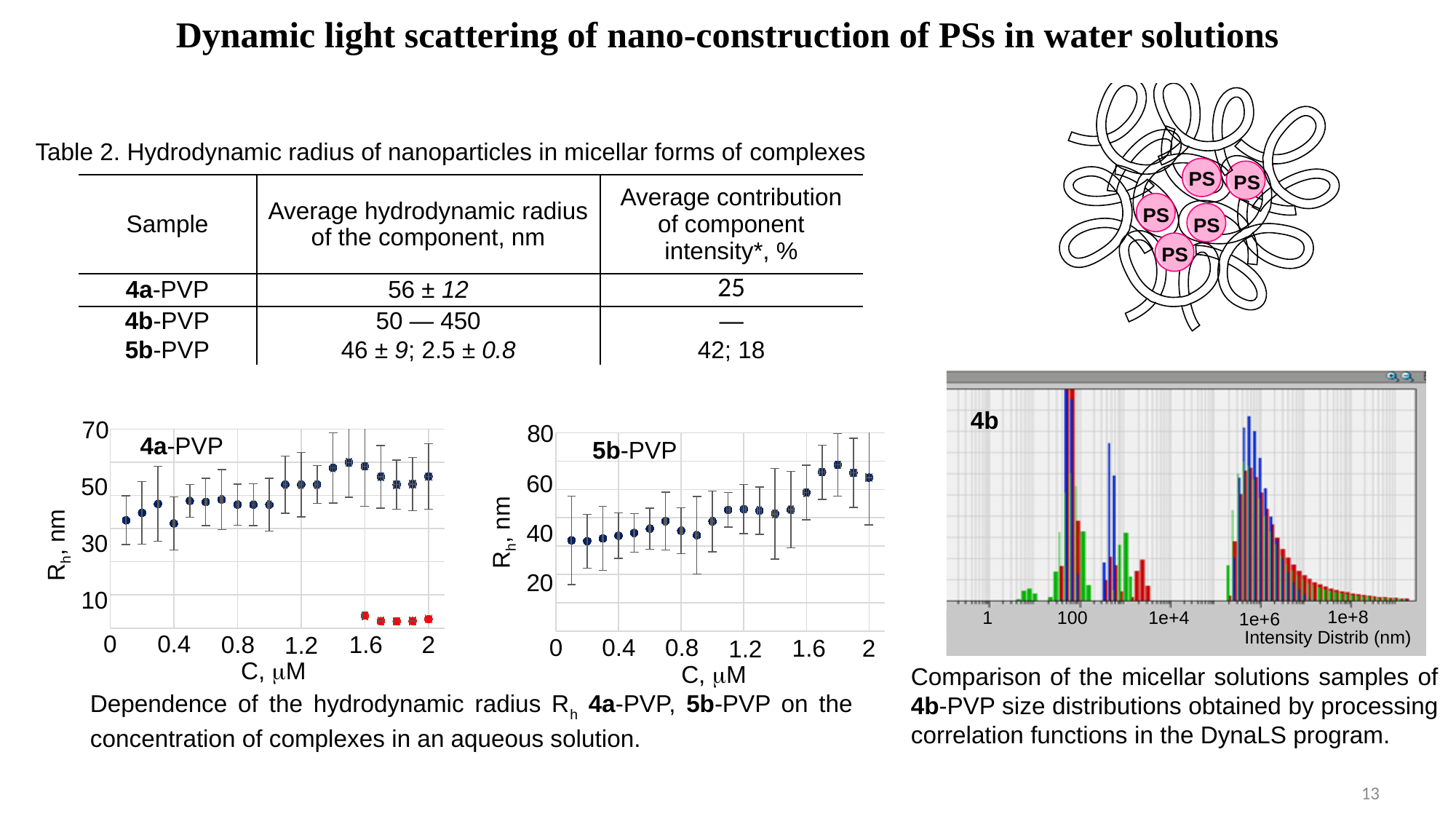
What is the y-axis label of the 5b-PVP chart? Rh, nm In the 4a-PVP chart, do the blue values generally rise or fall as C increases from 0 to 2 μM? rise What kind of chart is the 4a-PVP chart? scatter chart with error bars In the 5b-PVP chart, do the values generally rise or fall as C increases from 0 to 2 μM? rise In the 5b-PVP chart, which is larger: the value at C = 0.1 μM or the value at C = 1.8 μM? C = 1.8 μM What is the x-axis label of the 4b size-distribution chart on the right? Intensity Distrib (nm) In the 5b-PVP chart, is the value at C = 1.8 μM greater or less than 60 nm? greater In the 4a-PVP chart, is the blue value at C = 0.1 μM greater or less than 50 nm? less In the 4a-PVP chart, is the blue value at C = 1.5 μM greater or less than 50 nm? greater In the 4a-PVP chart, which is larger: the blue value at C = 0.4 μM or the blue value at C = 1.5 μM? C = 1.5 μM